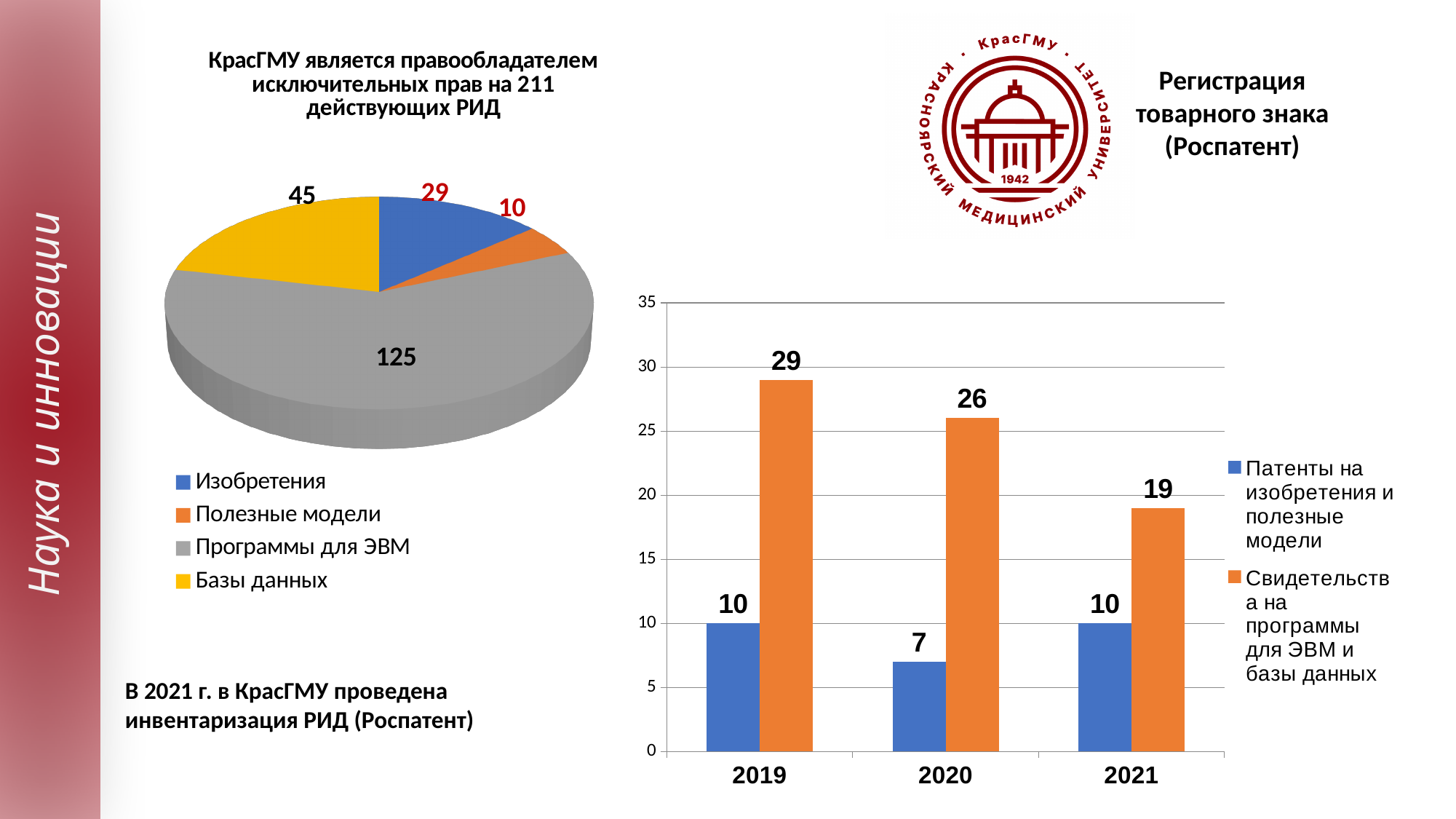
In the bar chart on the right, what is the difference between the two series in 2019? 19 In the pie chart on the left, what is the value for Программы для ЭВМ? 125 In the pie chart on the left, what is the value for Базы данных? 45 In the bar chart on the right, what is the value for Свидетельства на программы для ЭВМ и базы данных in 2020? 26 In the bar chart on the right, how do the values for Свидетельства на программы для ЭВМ и базы данных change from 2019 to 2021? They fall In the pie chart on the left, which category has the largest value? Программы для ЭВМ In the bar chart on the right, what is the value for Патенты на изобретения и полезные модели in 2020? 7 In the pie chart on the left, which category has the smallest value? Полезные модели What kind of chart is the chart on the right of the slide? Bar chart In the pie chart on the left, how many categories are shown? 4 In the pie chart on the left, what is the difference between the values for Базы данных and Изобретения? 16 In the bar chart on the right, how many series does the legend list? 2